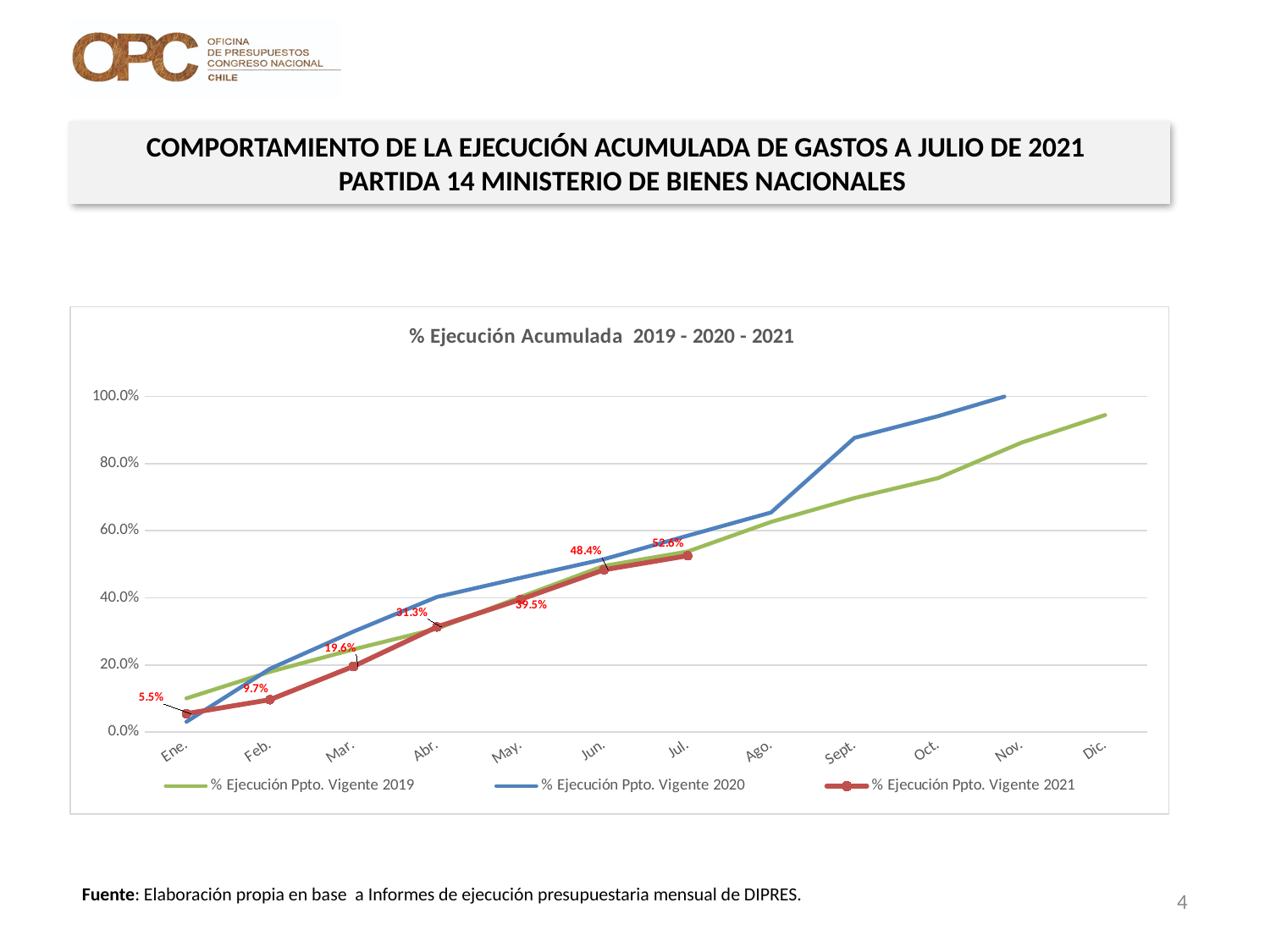
What is the value of % Ejecución Ppto. Vigente 2021 in Abr.? 31.3% What is the value of % Ejecución Ppto. Vigente 2021 in Jun.? 48.4% Does the 2021 series rise or fall from Ene. to Jul.? rise What is the value of % Ejecución Ppto. Vigente 2021 in Mar.? 19.6% In Sept., which series has the higher value: 2019 or 2020? % Ejecución Ppto. Vigente 2020 What kind of chart is shown on the slide? line chart Is the value for % Ejecución Ppto. Vigente 2020 in Nov. greater or less than 80%? greater How many months are shown on the x axis? 12 What is the value of % Ejecución Ppto. Vigente 2021 in Ene.? 5.5% Is the value for % Ejecución Ppto. Vigente 2019 in Dic. greater or less than 80%? greater How many series does the legend list? 3 What is the difference between the 2021 values for Mar. and Feb.? 9.9 percentage points